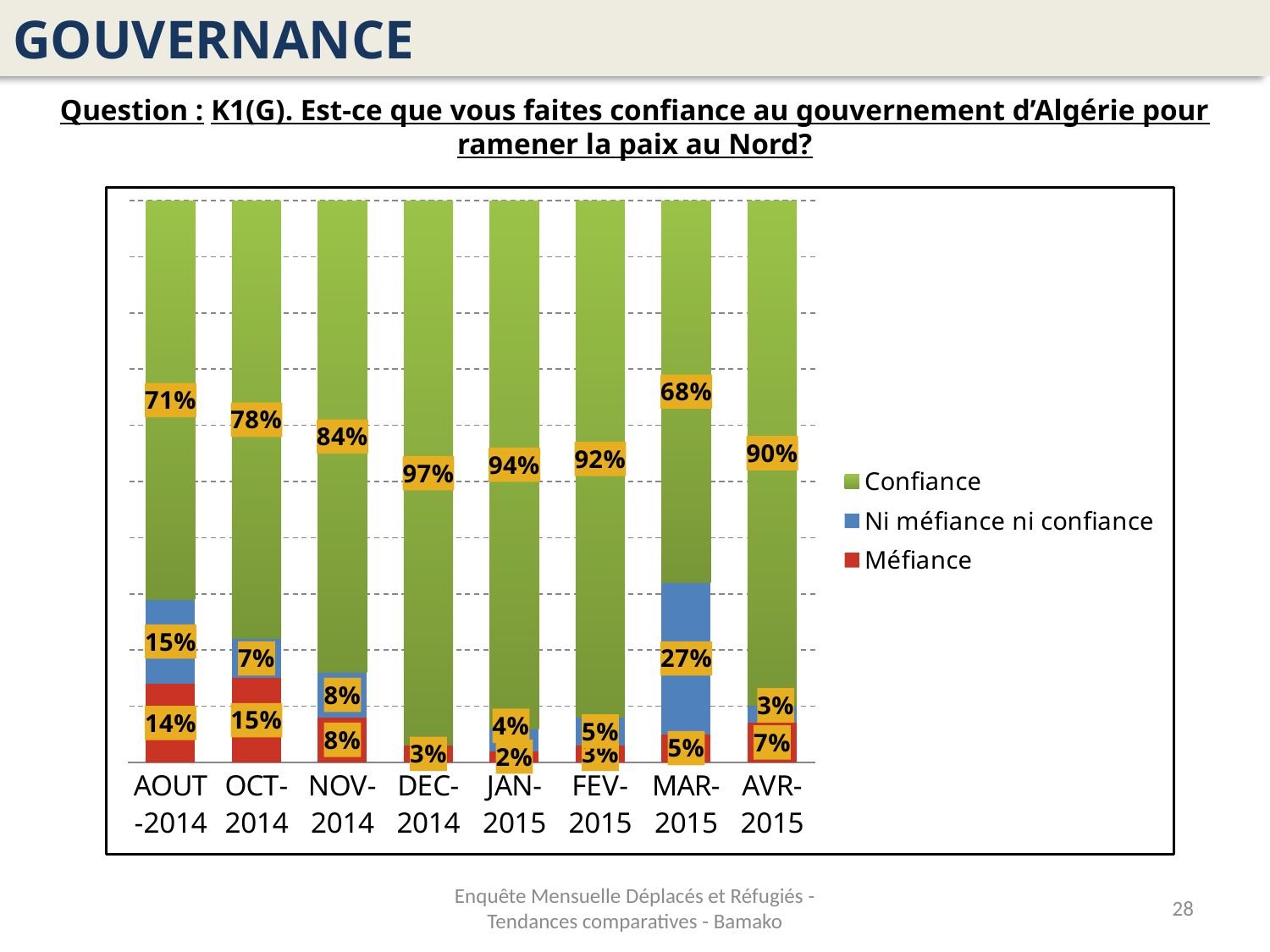
What is the difference between the Confiance values for OCT-2014 and AOUT-2014? 7% What is the Méfiance value for OCT-2014? 15% What kind of chart is shown on the slide? stacked bar chart What is the Ni méfiance ni confiance value for MAR-2015? 27% How many months (categories) are shown on the x axis? 8 How many series does the legend list? 3 Which month has the lowest Confiance value? MAR-2015 Which series is shown in green in the legend? Confiance Which is larger, the Méfiance value for AOUT-2014 or for NOV-2014? AOUT-2014 What is the Confiance value for AVR-2015? 90% Which month has the highest Confiance value? DEC-2014 What is the Confiance value for DEC-2014? 97%